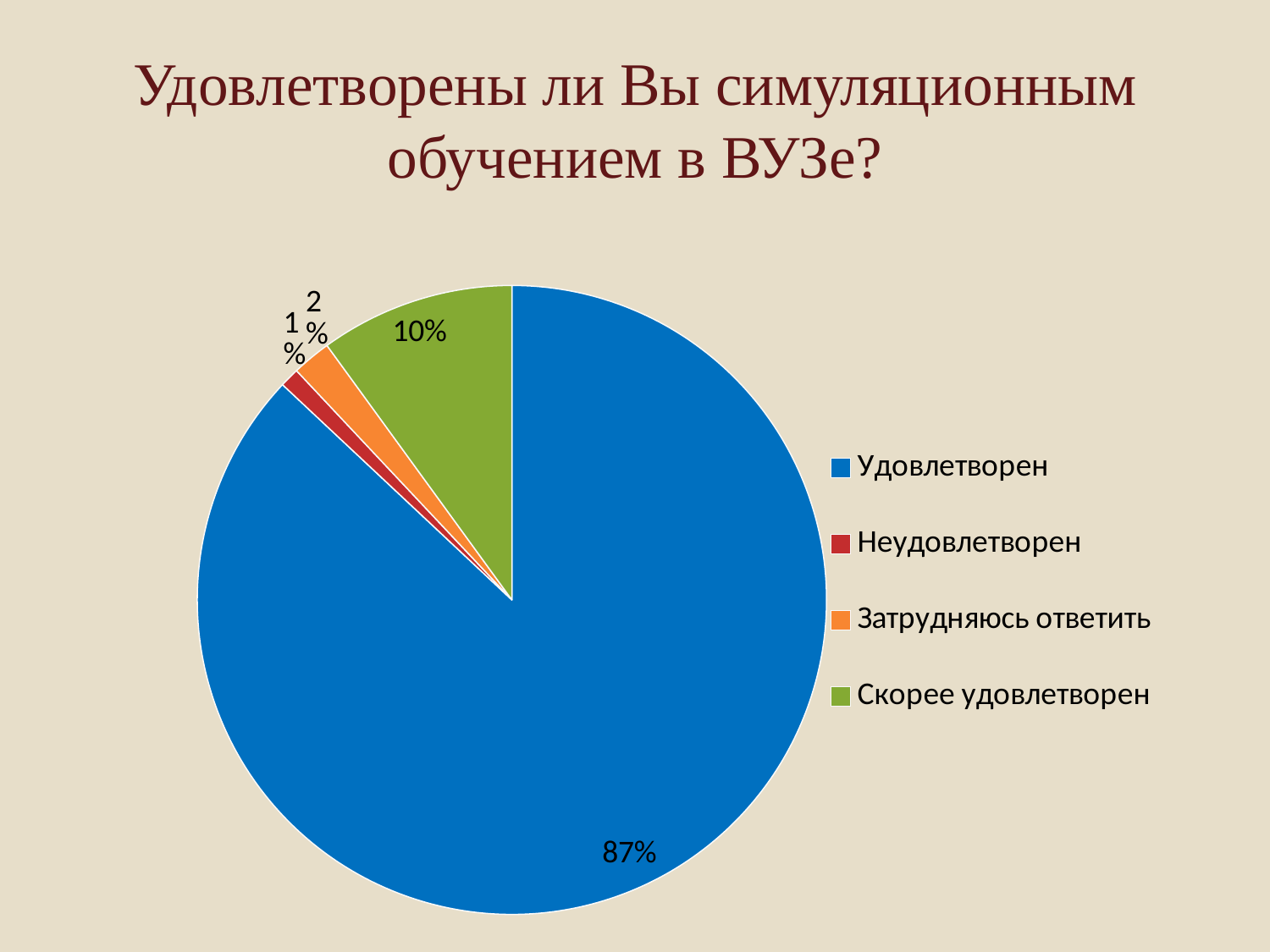
What is the title of the slide? Удовлетворены ли Вы симуляционным обучением в ВУЗе? What percentage of respondents answered "Скорее удовлетворен"? 10% Which response category has the smallest share of the pie? Неудовлетворен What percentage of respondents answered "Неудовлетворен"? 1% Which response category has the largest share of the pie? Удовлетворен What colour is the slice for "Скорее удовлетворен"? green What percentage of respondents answered "Затрудняюсь ответить"? 2% What type of chart is shown on the slide? pie chart What is the difference in percentage points between "Удовлетворен" and "Скорее удовлетворен"? 77 What percentage of respondents answered "Удовлетворен"? 87% Which is larger: the share for "Скорее удовлетворен" or the share for "Затрудняюсь ответить"? Скорее удовлетворен How many categories does the legend list? 4